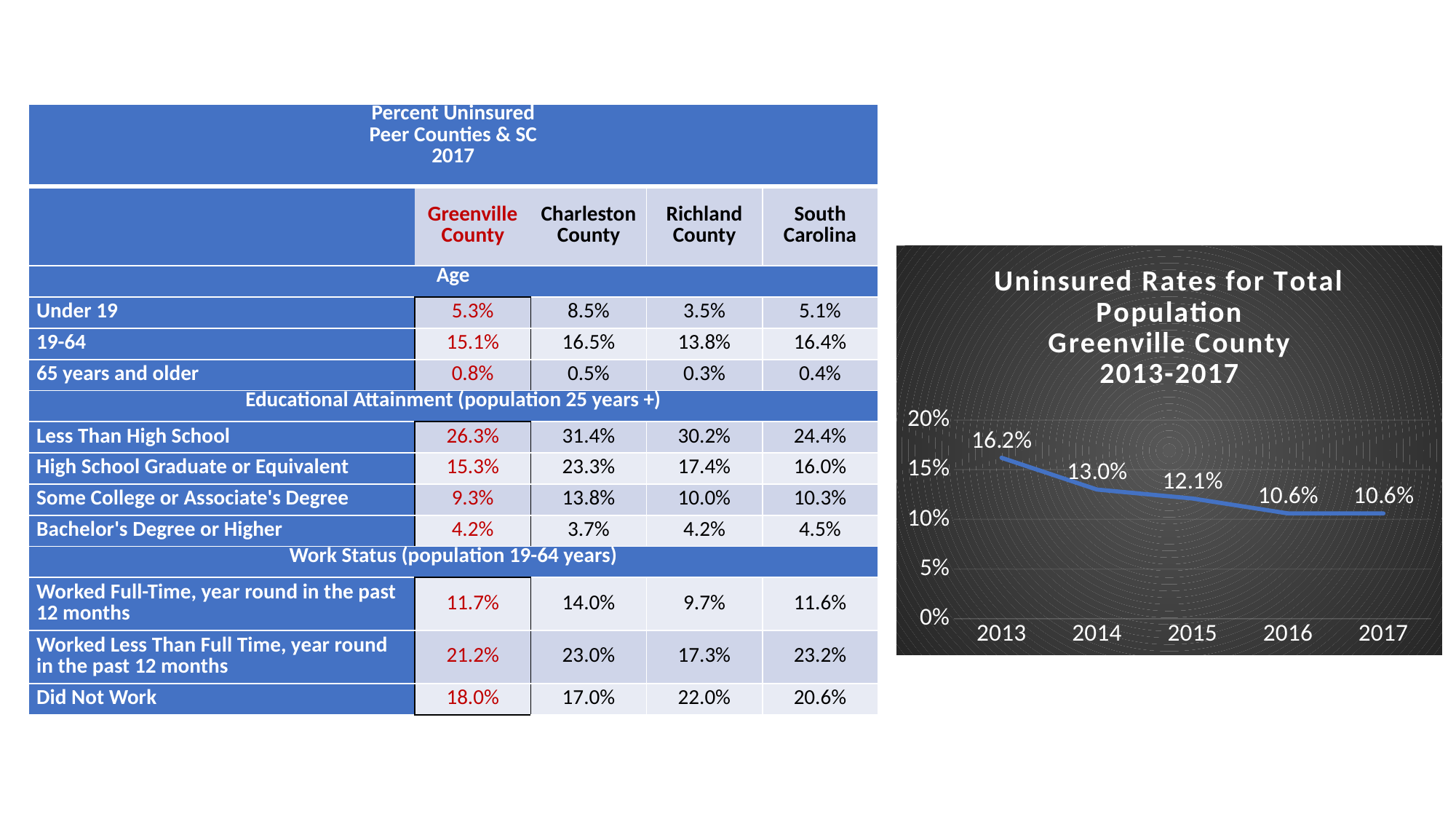
How many years are plotted in the line chart? 5 In the line chart, which year had a higher uninsured rate, 2014 or 2016? 2014 In the line chart, by how many percentage points did the uninsured rate fall from 2013 to 2014? 3.2 percentage points In the line chart, what was the uninsured rate for Greenville County in 2017? 10.6% In the line chart, what was the uninsured rate for Greenville County in 2013? 16.2% In the line chart, which year has the highest uninsured rate? 2013 In the line chart, what was the uninsured rate for Greenville County in 2015? 12.1% What is the title of the line chart? Uninsured Rates for Total Population Greenville County 2013-2017 In the line chart, what is the difference between the 2013 and 2017 uninsured rates? 5.6 percentage points What type of chart is shown on the right side of the slide? Line chart In the line chart, is the 2013 uninsured rate greater or less than 15%? greater In the line chart, does the uninsured rate generally rise or fall from 2013 to 2017? Fall